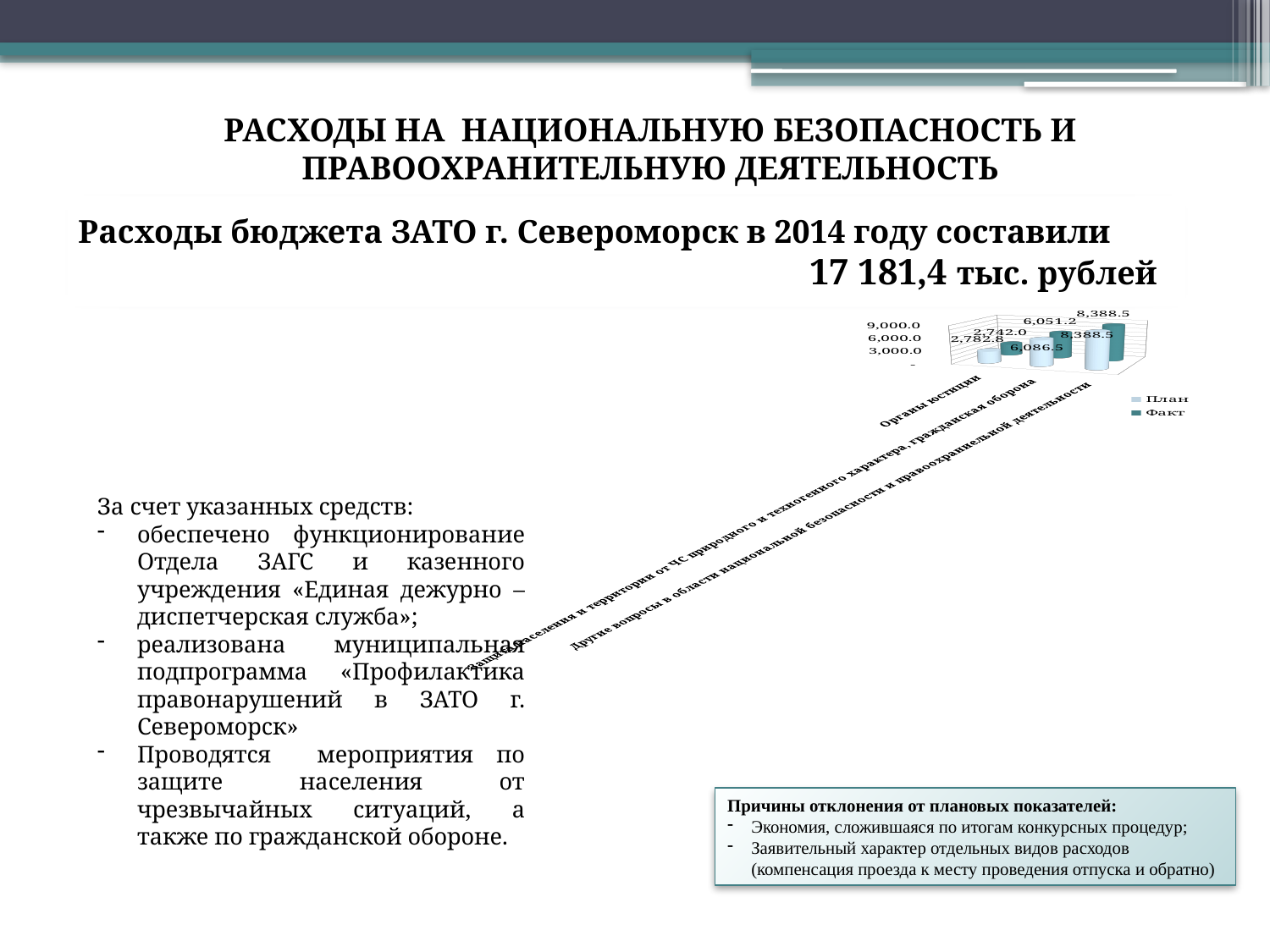
Which category has the highest План value? Другие вопросы в области национальной безопасности и правоохранительной деятельности What are the two series named in the chart legend? План and Факт What is the Факт value for Другие вопросы в области национальной безопасности и правоохранительной деятельности? 8,388.5 What kind of chart is shown on the slide? bar chart What is the План value for Другие вопросы в области национальной безопасности и правоохранительной деятельности? 8,388.5 How many series does the chart legend list? 2 What is the План value for Органы юстиции? 2,782.8 For Органы юстиции, which is larger: План or Факт? План Which category has the lowest Факт value? Органы юстиции What is the difference between План and Факт for Органы юстиции? 40.8 What is the Факт value for Органы юстиции? 2,742.0 How many categories are plotted on the chart? 3